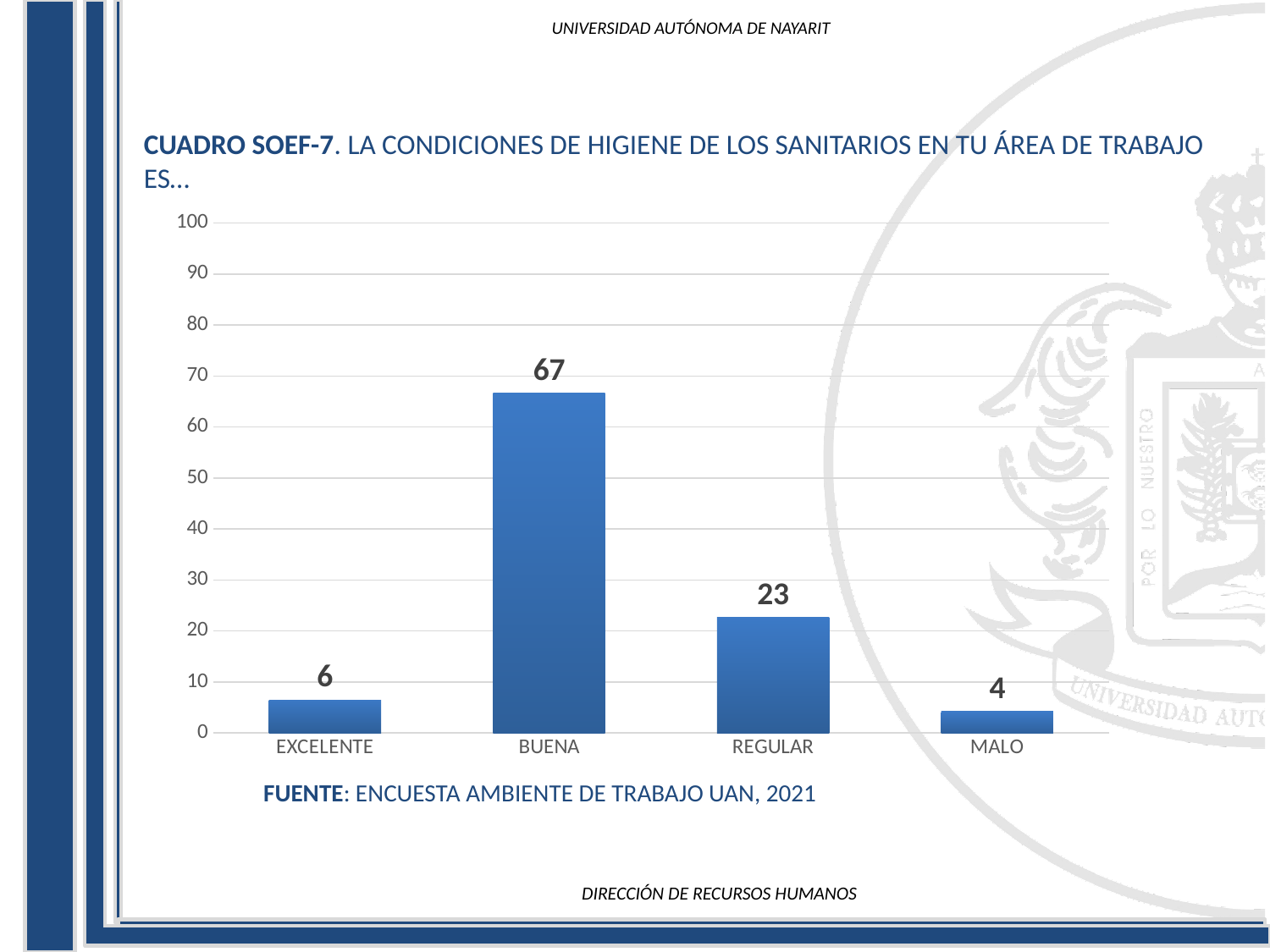
What is the value for EXCELENTE? 6 What source is cited below the chart? ENCUESTA AMBIENTE DE TRABAJO UAN, 2021 What is the difference between the values for BUENA and REGULAR? 44 Which category has the lowest value? MALO What is the value for MALO? 4 Is the value for REGULAR greater or less than 30? less What is the value for BUENA? 67 What kind of chart is shown on the slide? bar chart How many categories are shown on the x axis? 4 Which category has the highest value? BUENA Which is larger, the value for EXCELENTE or the value for MALO? EXCELENTE What is the value for REGULAR? 23